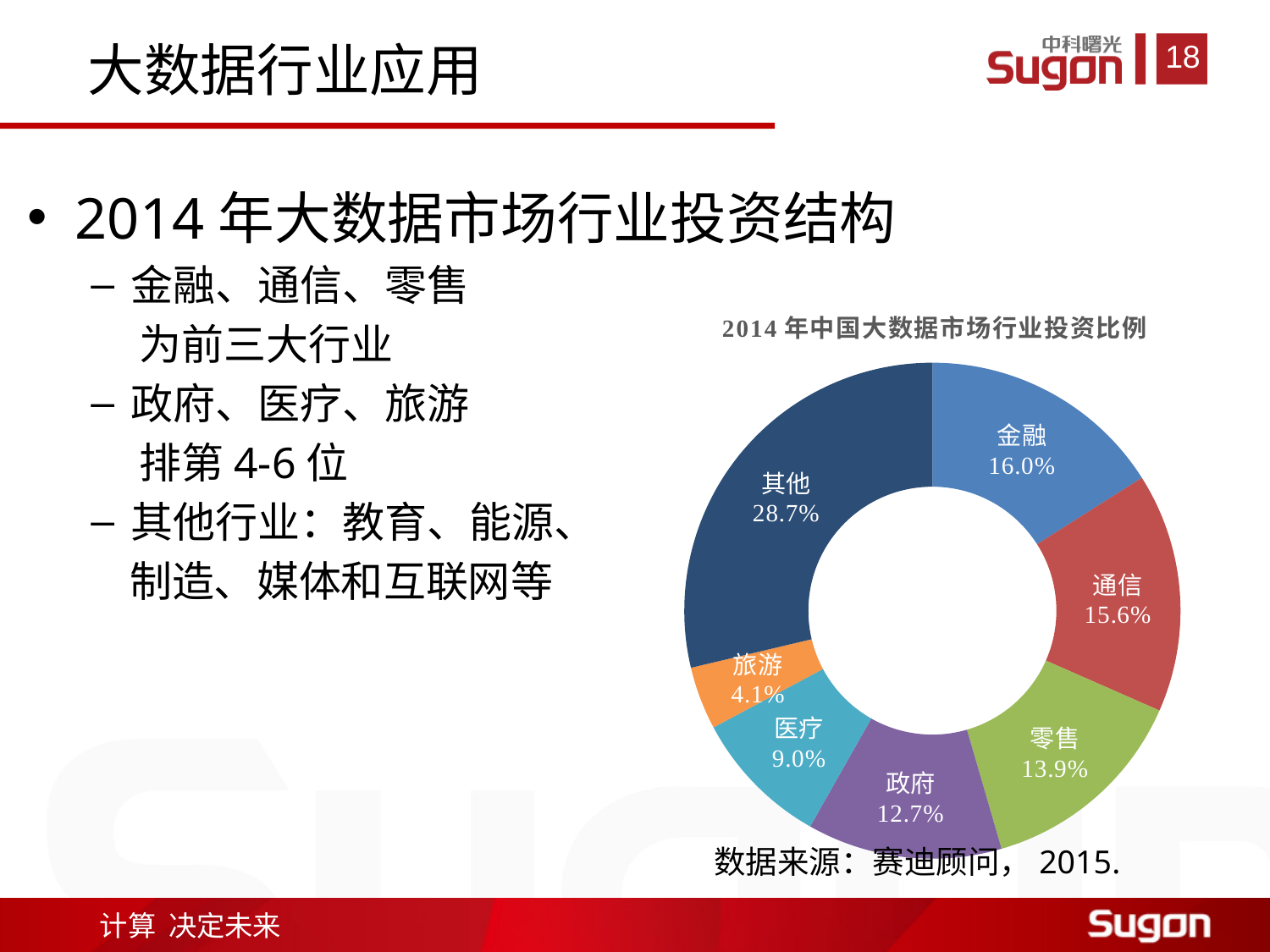
What share of the chart does 金融 account for? 16.0% What is the value shown for 政府? 12.7% Which category has the smallest slice? 旅游 What is the value shown for 通信? 15.6% What is the title of the chart? 2014年中国大数据市场行业投资比例 What is the value shown for 医疗? 9.0% What is the difference in percentage points between 其他 and 金融? 12.7 What is the difference in percentage points between 医疗 and 旅游? 4.9 Which category has the largest slice? 其他 What type of chart is shown on the slide? Pie chart (donut) Which is larger, 零售 or 政府? 零售 How many slices does the chart have? 7